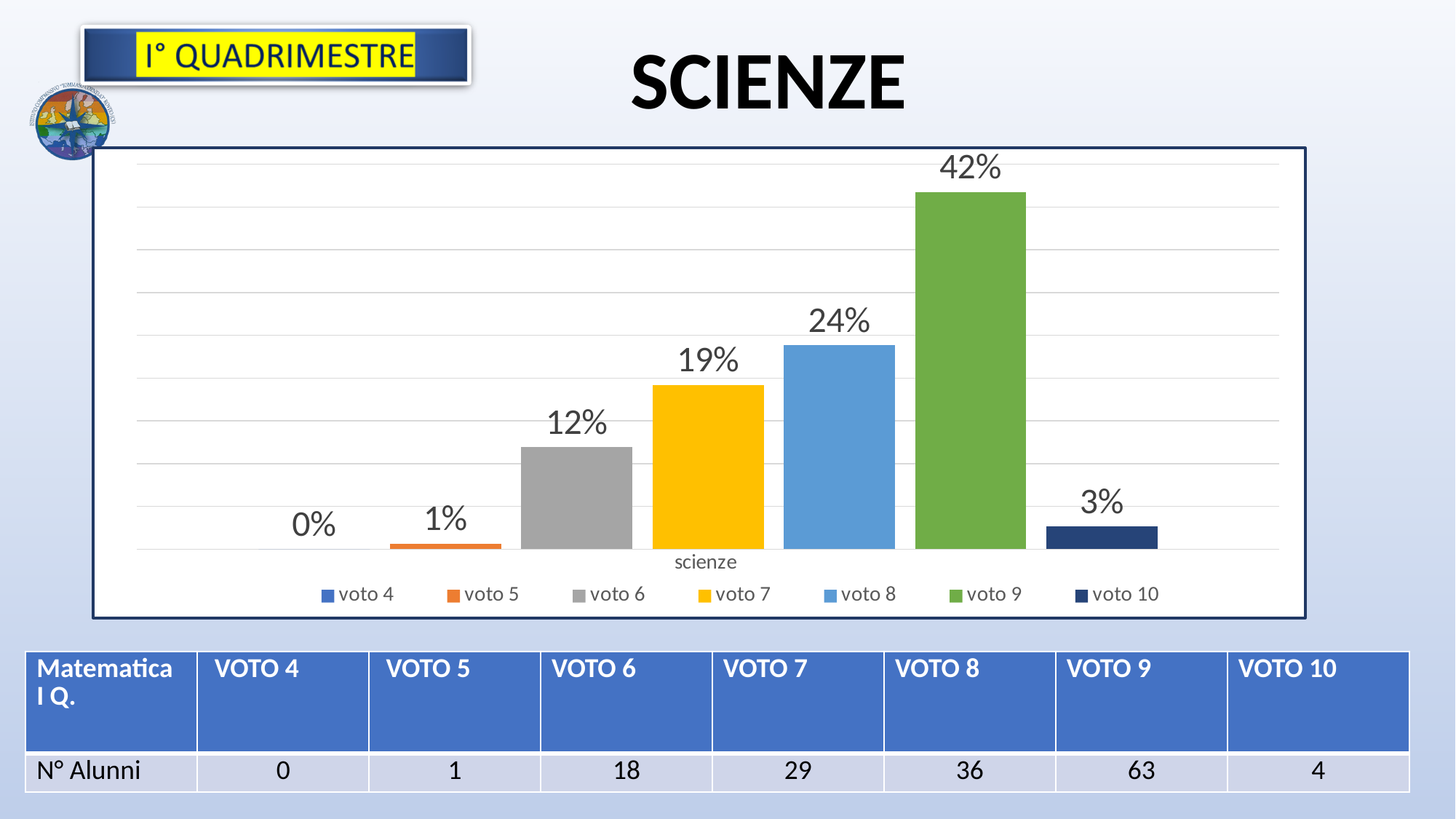
What percentage is shown for voto 6? 12% What is the difference in percentage points between voto 7 and voto 6? 7% Which series has the highest percentage? voto 9 Which is larger, the percentage for voto 7 or for voto 8? voto 8 How many series does the legend list? 7 What is the difference in percentage points between voto 9 and voto 8? 18% What percentage is shown for voto 10? 3% What percentage is shown for voto 5? 1% What kind of chart is shown? bar chart Which series has the lowest percentage? voto 4 What percentage is shown for voto 9? 42% What is the title of the slide above the chart? SCIENZE